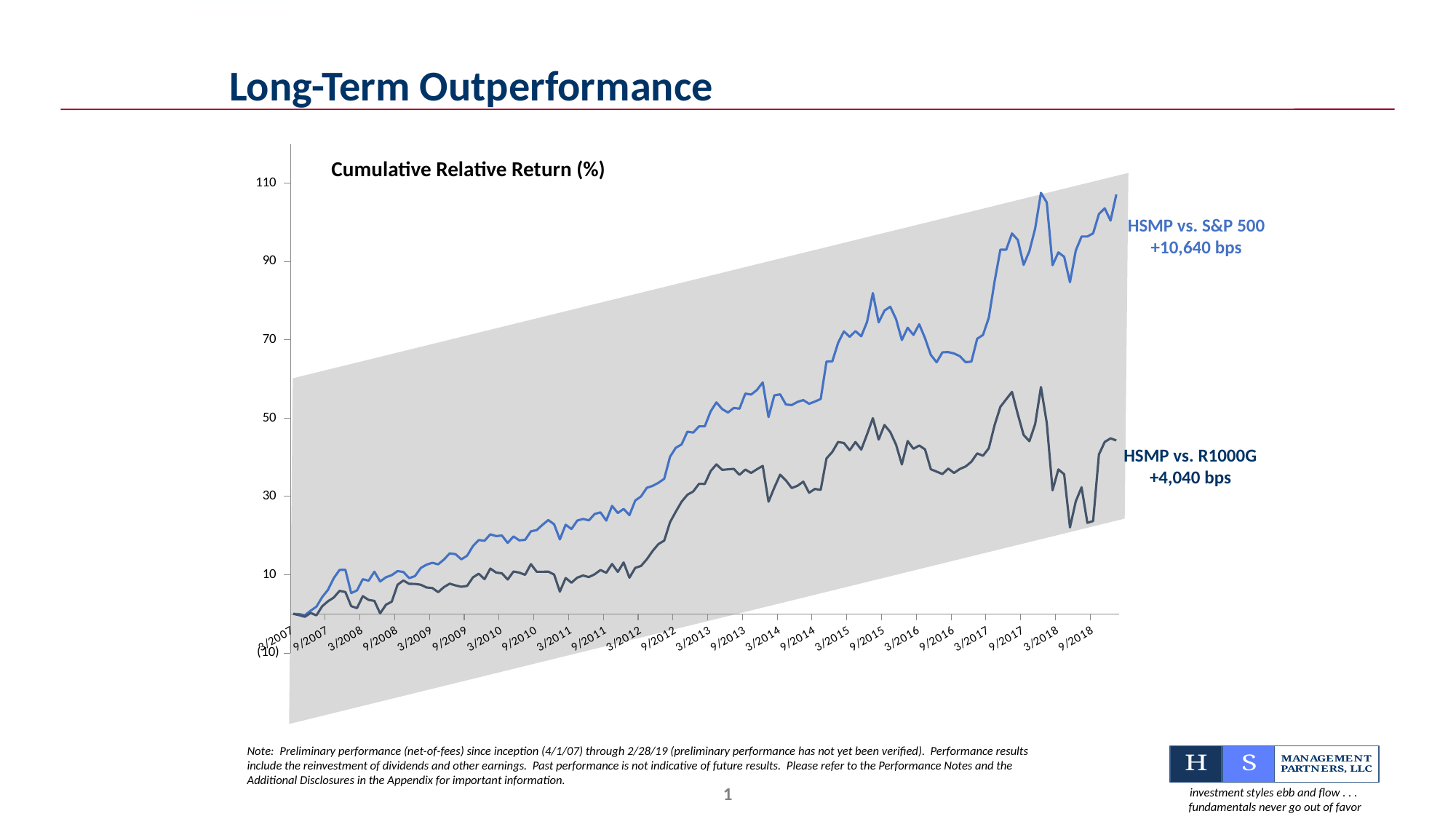
What is the highest value labelled on the y axis? 110 Is the value of the HSMP vs. R1000G line at 9/2012 greater or less than 30? less What cumulative outperformance in basis points is labelled for HSMP vs. R1000G? +4,040 bps Overall, do the cumulative relative return lines rise or fall from 3/2007 to 9/2018? rise How many date labels are shown on the x axis? 24 What kind of chart is shown on the slide? line chart Is the value of the HSMP vs. S&P 500 line at 9/2018 greater or less than 90? greater What is the title of the chart? Cumulative Relative Return (%) What cumulative outperformance in basis points is labelled for HSMP vs. S&P 500? +10,640 bps How many series are plotted on the chart? 2 Which series ends higher at the right side of the chart, HSMP vs. S&P 500 or HSMP vs. R1000G? HSMP vs. S&P 500 Is the value of the HSMP vs. R1000G line at 9/2018 greater or less than 50? less